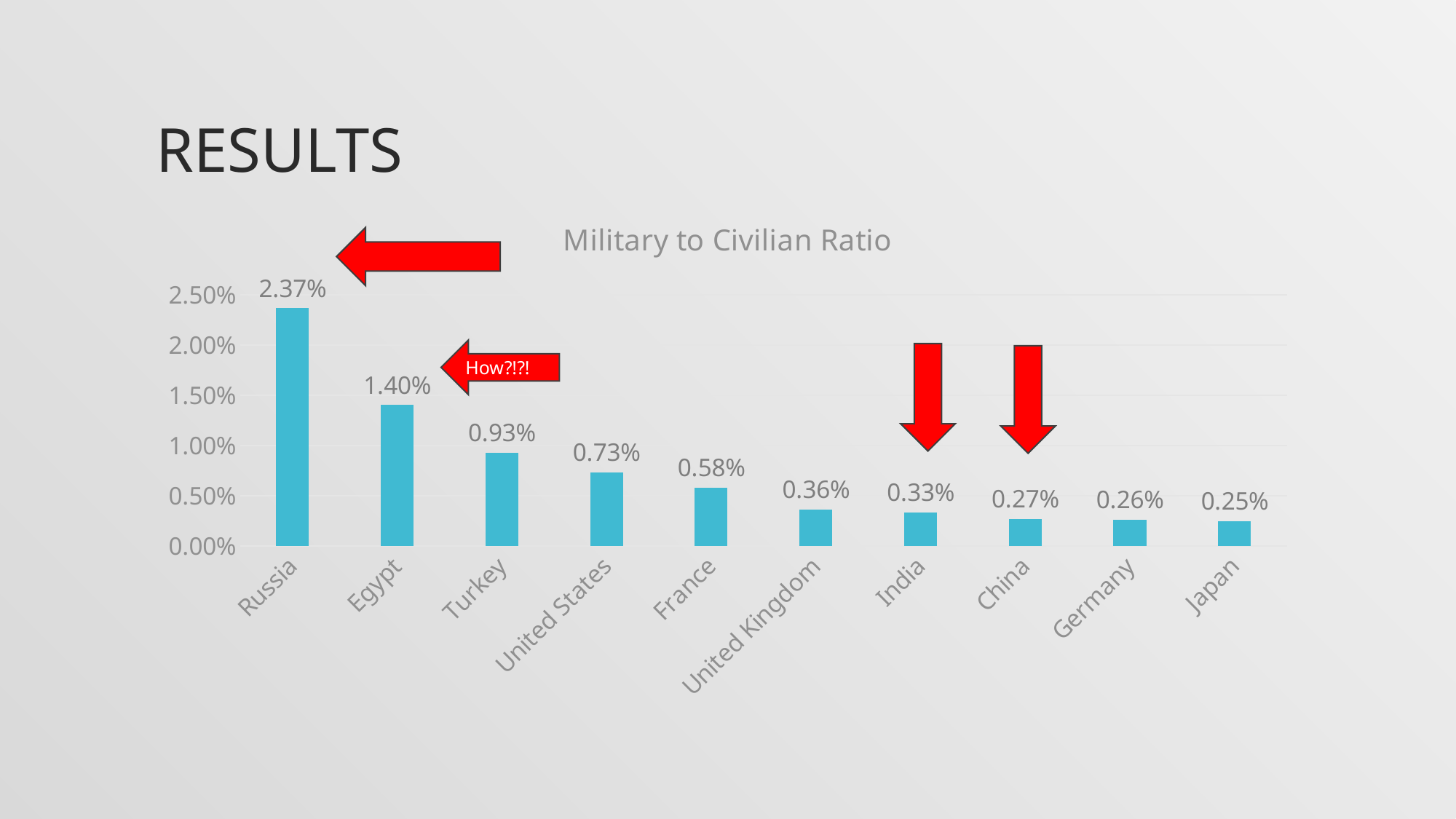
What kind of chart is shown on the slide? Bar chart Which has a higher Military to Civilian Ratio, Egypt or Turkey? Egypt What is the Military to Civilian Ratio for China? 0.27% What is the difference between the Military to Civilian Ratio of Russia and Egypt? 0.97% Which country has the lowest Military to Civilian Ratio? Japan What is the difference between the Military to Civilian Ratio of Turkey and France? 0.35% What is the Military to Civilian Ratio for the United States? 0.73% Is the value for Egypt greater or less than 1.00%? greater How many countries are shown in the chart? 10 What is the Military to Civilian Ratio for Russia? 2.37% Which country has the highest Military to Civilian Ratio? Russia Do the values rise or fall from left to right along the x axis? Fall